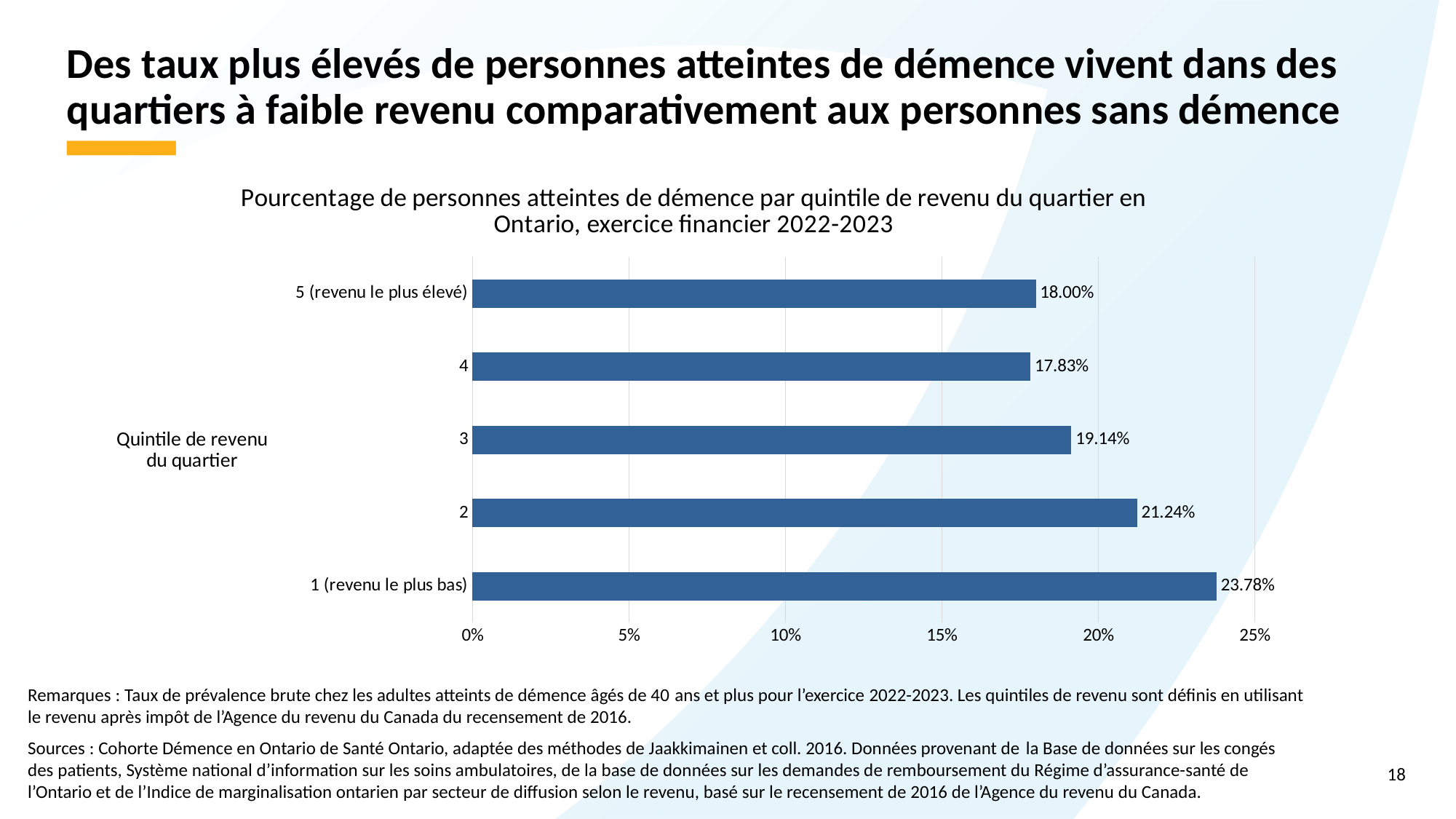
What is the value shown for quintile 2? 21.24% What is the difference between the values for quintile 1 (revenu le plus bas) and quintile 5 (revenu le plus élevé)? 5.78% Is the value for quintile 4 greater or less than 20%? less How many income quintiles are shown in the chart? 5 Which has a larger value, quintile 2 or quintile 3? Quintile 2 What is the title of the chart? Pourcentage de personnes atteintes de démence par quintile de revenu du quartier en Ontario, exercice financier 2022-2023 Which income quintile has the lowest percentage of people with dementia? 4 Which income quintile has the highest percentage of people with dementia? 1 (revenu le plus bas) What type of chart is shown on the slide? Bar chart What is the value shown for quintile 3? 19.14% What is the percentage of people with dementia for quintile 5 (revenu le plus élevé)? 18.00% What is the percentage of people with dementia for quintile 1 (revenu le plus bas)? 23.78%